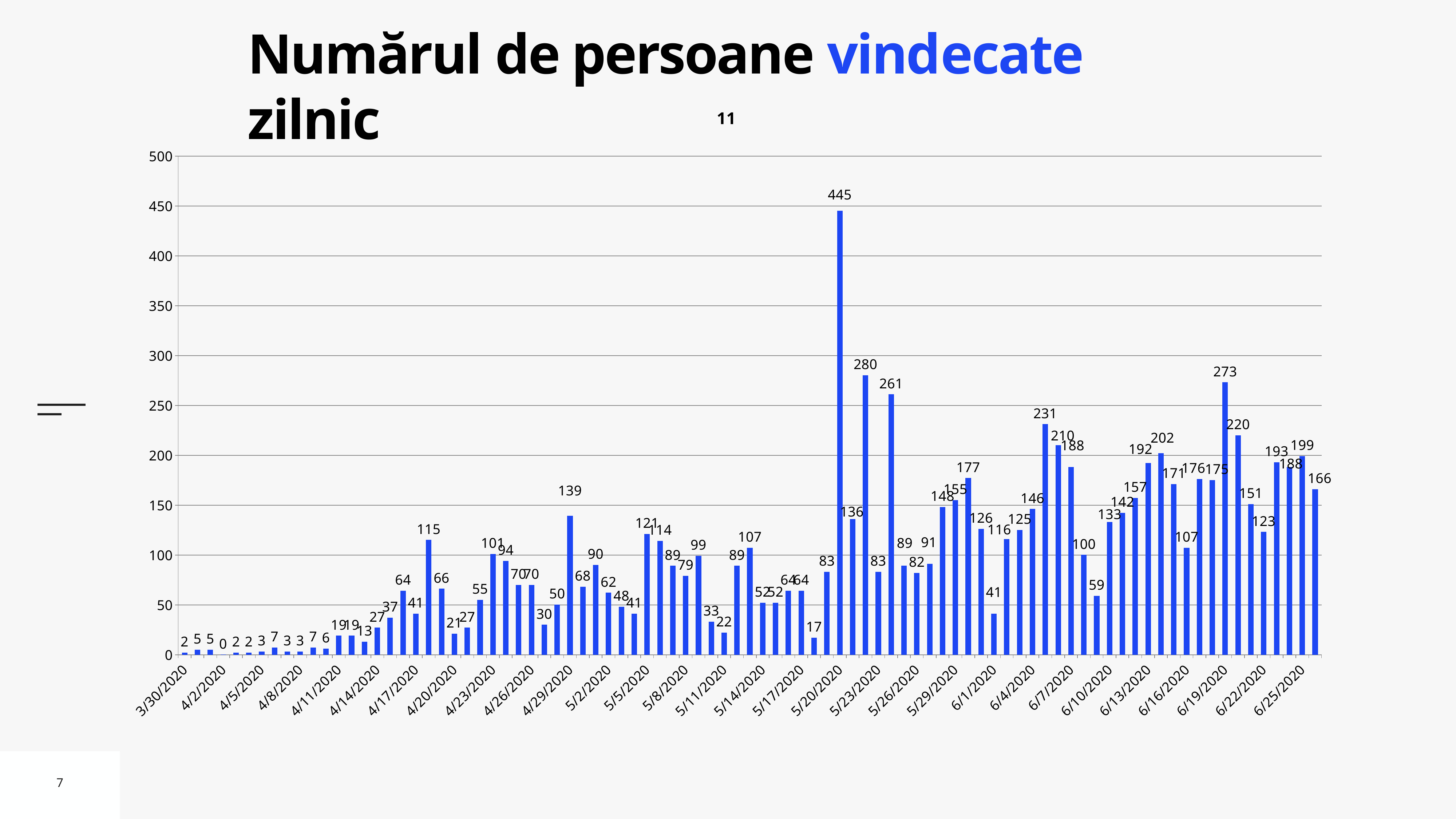
Which date has the highest value in the chart? 5/20/2020 What is the value for 4/29/2020? 139 What is the title of the slide? Numărul de persoane vindecate zilnic What is the value for 4/2/2020? 0 Is the value for 5/20/2020 greater or less than 400? greater What is the highest value shown in the chart? 445 What is the value for 6/19/2020? 273 What type of chart is shown on the slide? bar chart What is the difference between the highest bar (445) and the second highest bar (280)? 165 Overall, do the values rise or fall from the end of March to the end of June? rise